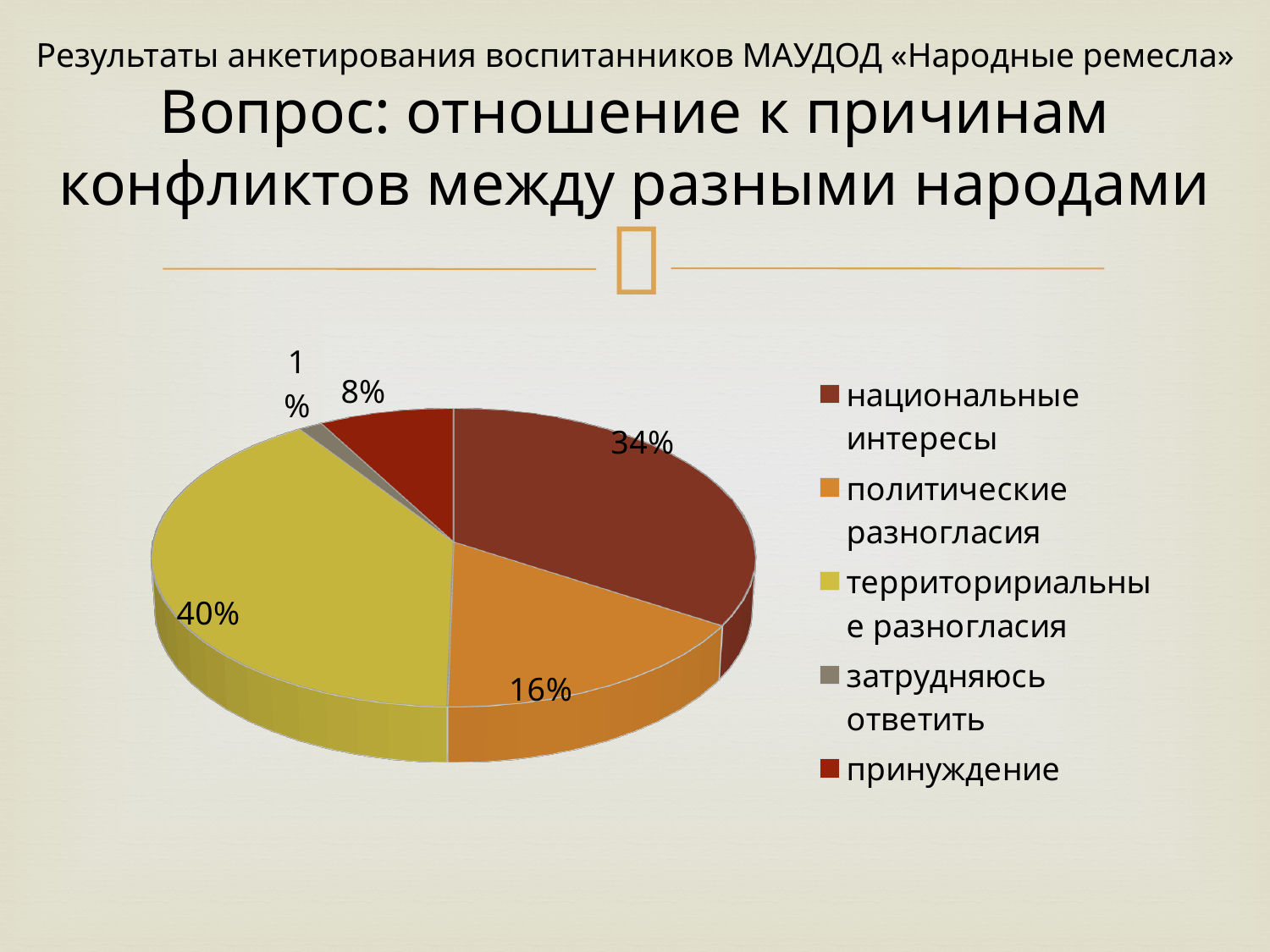
Which category has the smallest slice of the pie? затрудняюсь ответить What percentage is shown for «затрудняюсь ответить»? 1% What percentage is shown for «принуждение»? 8% What percentage is shown for «территориририальные разногласия»? 40% How many slices does the pie chart have? 5 What type of chart is shown on the slide? pie chart What colour is the slice for «национальные интересы»? dark red (brown) What share of the pie is labelled «национальные интересы»? 34% What is the difference in percentage points between «территориририальные разногласия» and «национальные интересы»? 6 What percentage is shown for «политические разногласия»? 16% Which category has the largest slice of the pie? территоририальные разногласия Which is larger: the share for «политические разногласия» or the share for «принуждение»? политические разногласия